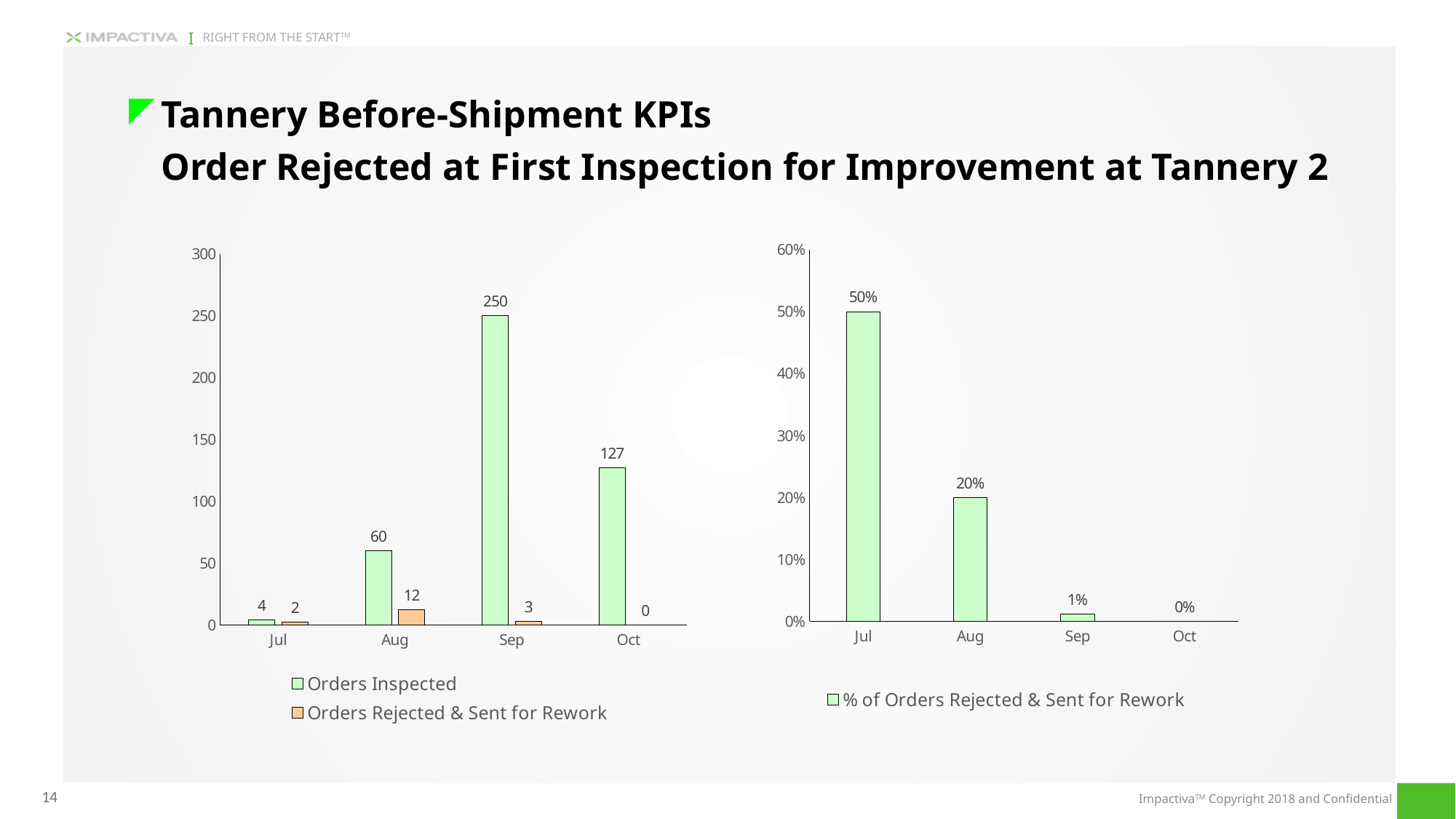
In the left chart, which month has the lowest number of Orders Inspected? Jul In the left chart, is the value of Orders Inspected for Oct greater or less than 100? greater What kind of chart is the right chart? bar chart In the right chart, what is the % of Orders Rejected & Sent for Rework for Jul? 50% In the left chart, what is the value of Orders Inspected for Sep? 250 In the left chart, how many series does the legend list? 2 In the right chart, what is the % of Orders Rejected & Sent for Rework for Oct? 0% In the left chart, which month has the highest number of Orders Inspected? Sep In the right chart, do the values rise or fall from Jul to Oct? fall In the left chart, what is the difference between Orders Inspected and Orders Rejected & Sent for Rework in Aug? 48 In the left chart, what is the value of Orders Rejected & Sent for Rework for Aug? 12 In the right chart, how many months are shown on the x axis? 4